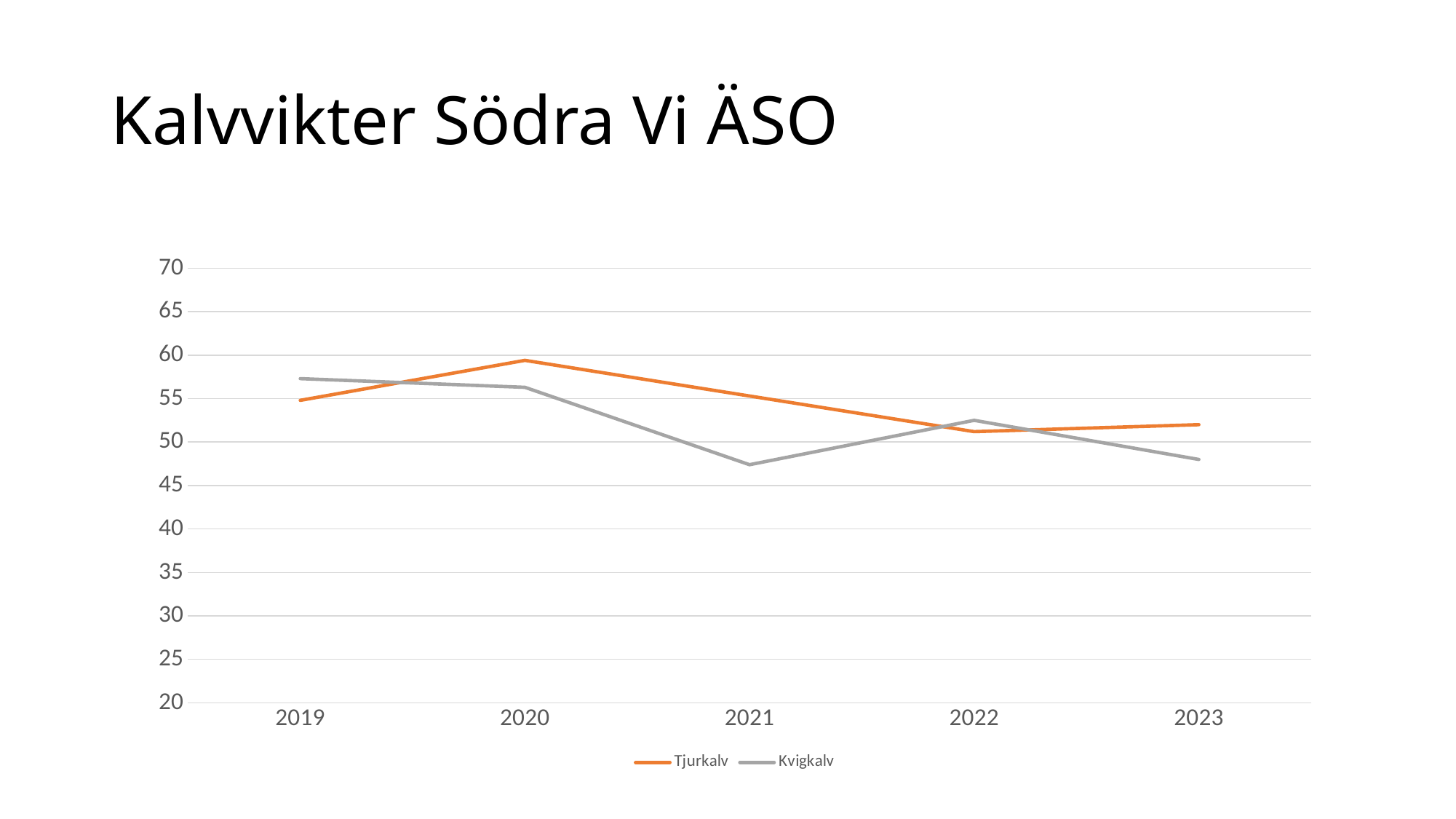
Does the Kvigkalv line rise or fall from 2020 to 2021? fall What colour is the Tjurkalv line? orange Is the value for Kvigkalv in 2023 greater or less than 50? less In 2021, which series has the higher value, Tjurkalv or Kvigkalv? Tjurkalv What kind of chart is shown on the slide? line chart Is the value for Tjurkalv in 2020 greater or less than 55? greater In 2019, which series has the higher value, Tjurkalv or Kvigkalv? Kvigkalv In which year does the Kvigkalv line reach its lowest value? 2021 In which year does the Tjurkalv line reach its highest value? 2020 How many series does the legend list? 2 Is the value for Kvigkalv in 2021 greater or less than 50? less How many years are shown on the x axis? 5